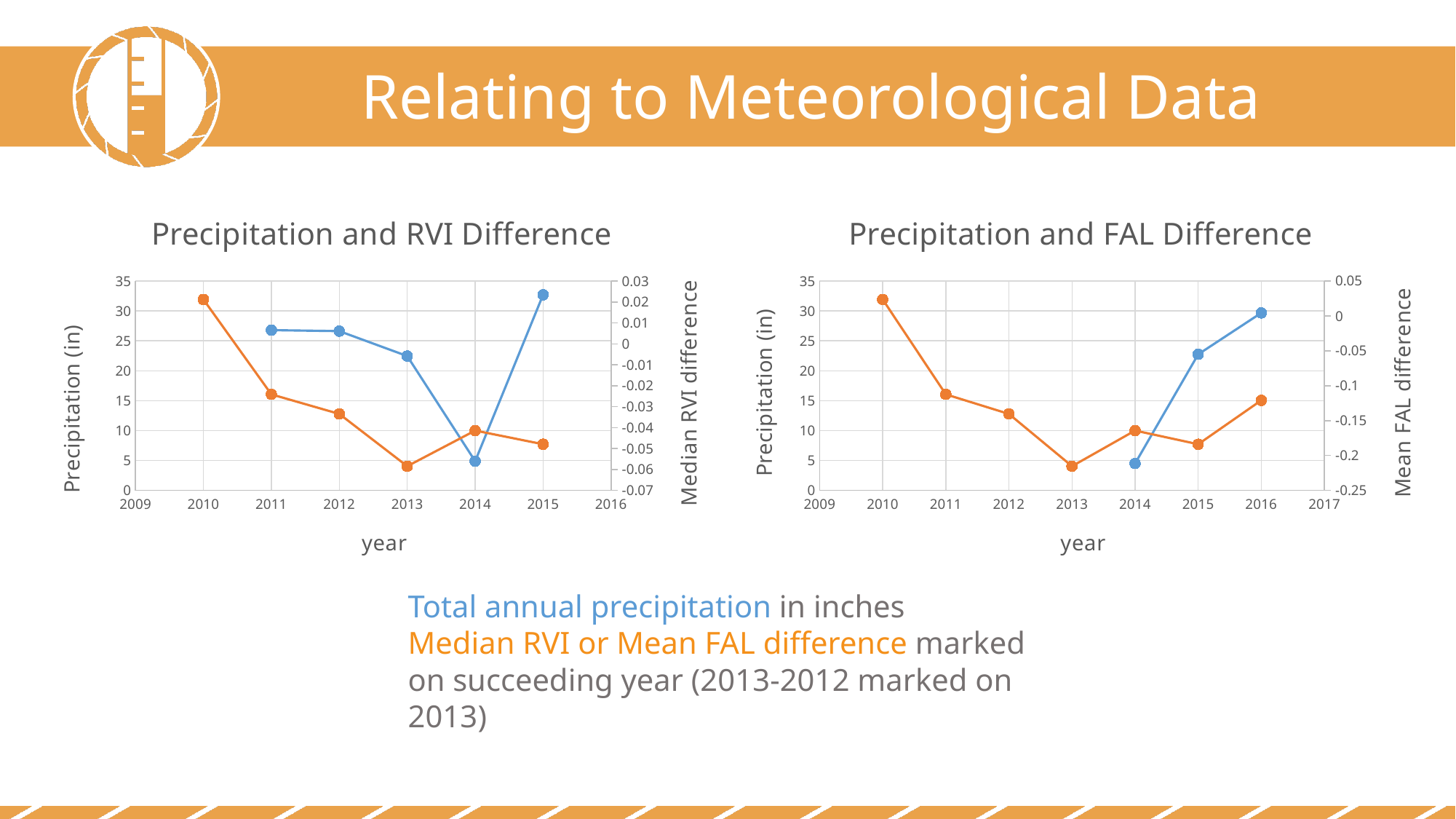
In the 'Precipitation and RVI Difference' chart, is the precipitation for 2010 greater or less than 30? greater What kind of chart is 'Precipitation and RVI Difference'? line chart In the 'Precipitation and RVI Difference' chart, how many precipitation data points are plotted? 6 In the 'Precipitation and RVI Difference' chart, which year has the lowest precipitation? 2013 In the 'Precipitation and FAL Difference' chart, which year has the highest mean FAL difference? 2016 In the 'Precipitation and FAL Difference' chart, is the precipitation for 2016 greater or less than 10? greater In the 'Precipitation and FAL Difference' chart, does the mean FAL difference rise or fall from 2014 to 2016? rise In the 'Precipitation and RVI Difference' chart, which year has the highest precipitation? 2010 In the 'Precipitation and RVI Difference' chart, is the median RVI difference for 2014 greater or less than -0.04? less In the 'Precipitation and FAL Difference' chart, which year has the lowest mean FAL difference? 2014 In the 'Precipitation and FAL Difference' chart, which year has higher precipitation, 2011 or 2014? 2011 In the 'Precipitation and FAL Difference' chart, how many precipitation data points are plotted? 7